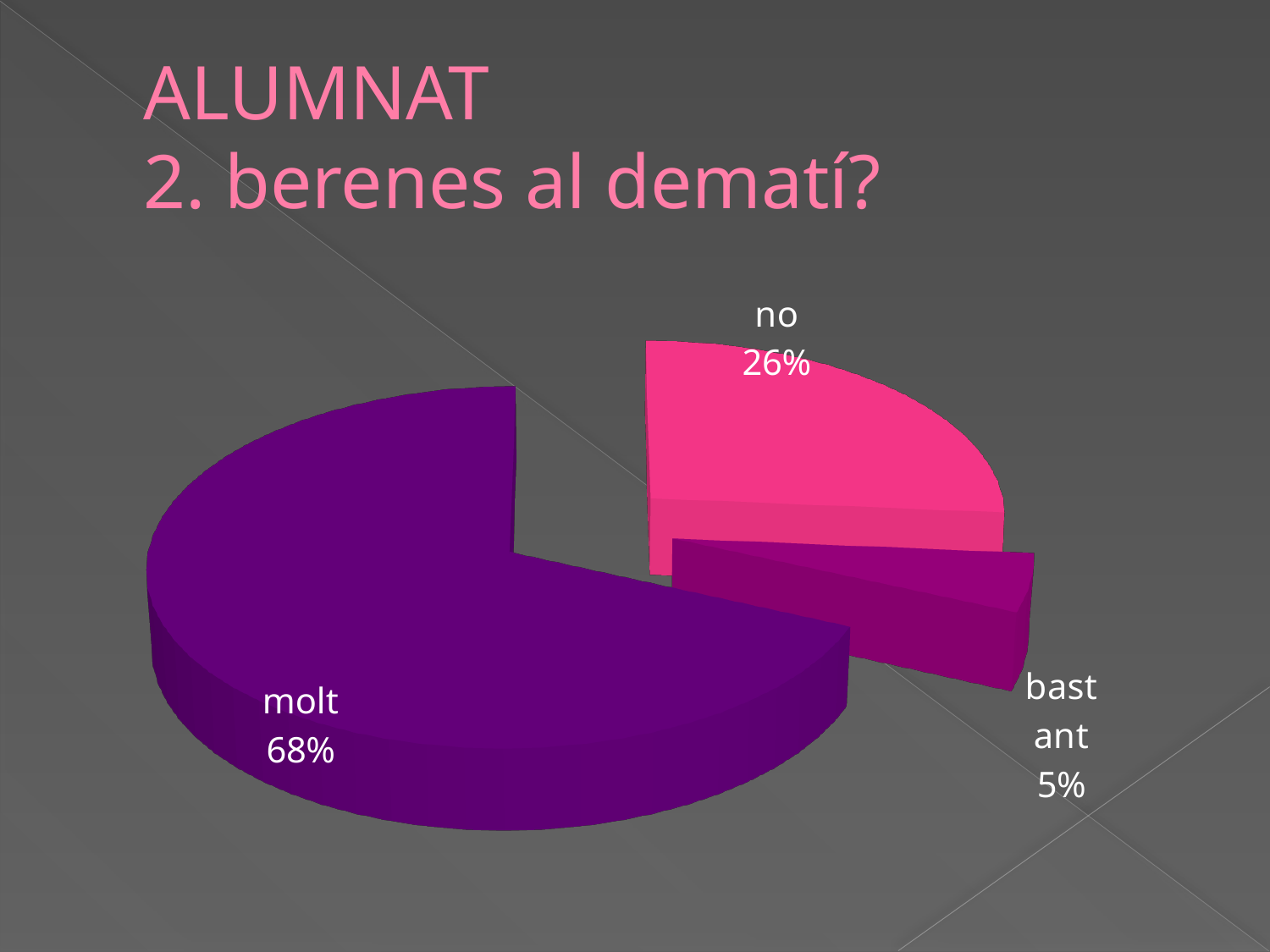
What is the difference in percentage points between the "molt" and "no" slices? 42 What is the difference in percentage points between the "no" and "bastant" slices? 21 What colour is the "molt" slice of the pie? purple What kind of chart is shown on the slide? pie chart Which slice is larger, "no" or "bastant"? no How many slices does the pie chart have? 3 Which category has the smallest share of the pie? bastant What percentage of the pie is labelled "molt"? 68% Which category has the largest share of the pie? molt What percentage of the pie is labelled "no"? 26% What percentage of the pie is labelled "bastant"? 5% What is the title of the slide containing the chart? ALUMNAT 2. berenes al dematí?